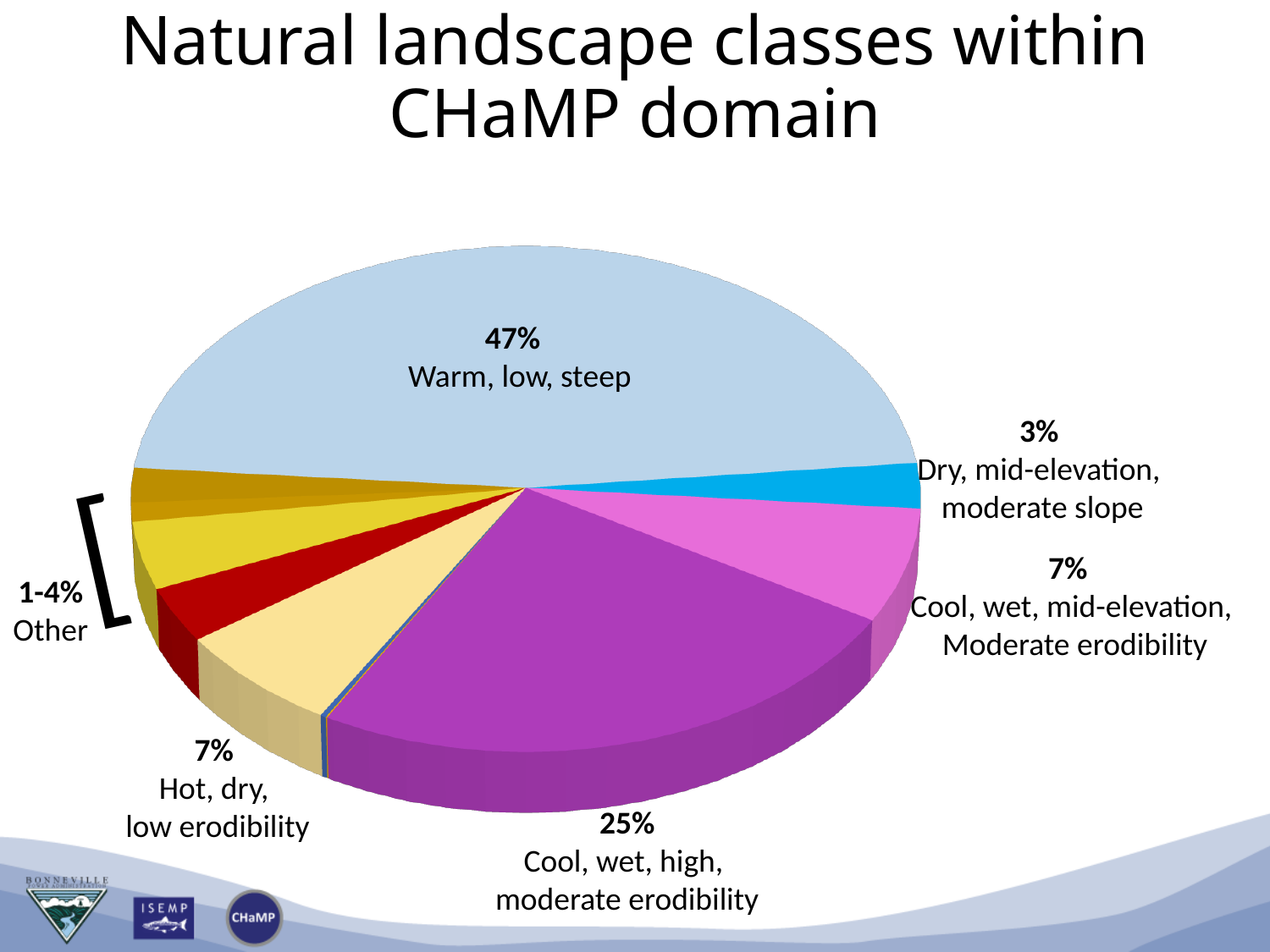
What kind of chart is shown on the slide? Pie chart What is the title of the slide containing the pie chart? Natural landscape classes within CHaMP domain What percentage of the pie is labelled "Warm, low, steep"? 47% Which has the larger share: "Cool, wet, high, moderate erodibility" or "Hot, dry, low erodibility"? Cool, wet, high, moderate erodibility What percentage is shown for "Cool, wet, high, moderate erodibility"? 25% What percentage range is given for the slices grouped as "Other"? 1-4% What percentage is shown for "Dry, mid-elevation, moderate slope"? 3% What percentage is shown for "Hot, dry, low erodibility"? 7% What percentage is shown for "Cool, wet, mid-elevation, Moderate erodibility"? 7% How many percentage points larger is the "Warm, low, steep" share than the "Cool, wet, high, moderate erodibility" share? 22 percentage points Which landscape class has the largest share of the pie? Warm, low, steep Among the categories with an exact percentage printed, which has the smallest share? Dry, mid-elevation, moderate slope